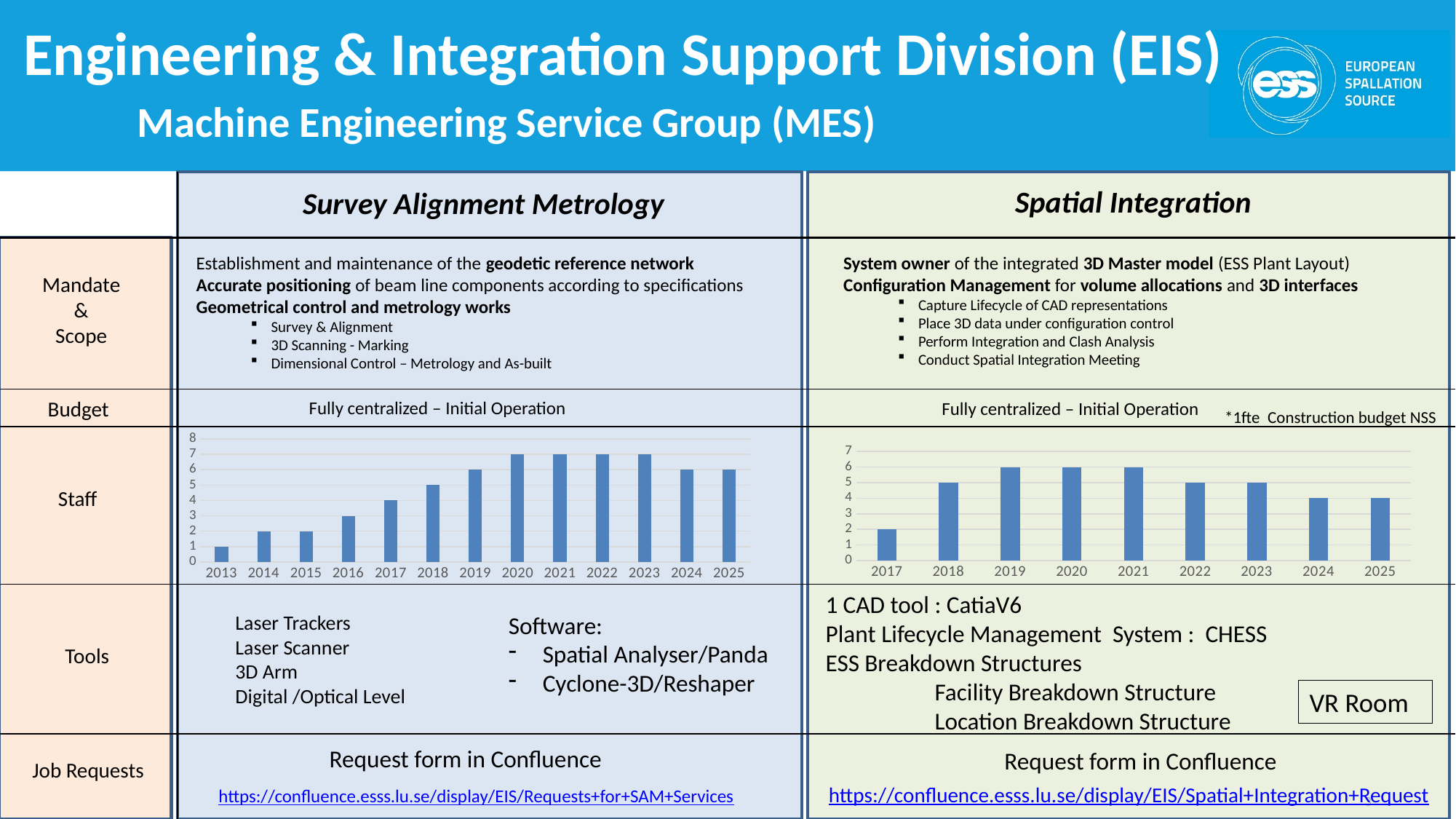
In the Spatial Integration staff chart, which is larger, the value for 2018 or the value for 2024? 2018 In the Survey Alignment Metrology staff chart, is the value for 2017 greater or less than 5? less In the Spatial Integration staff chart, how many years are shown on the x axis? 9 In the Spatial Integration staff chart, what is the value for 2017? 2 In the Survey Alignment Metrology staff chart, what is the value for 2020? 7 In the Survey Alignment Metrology staff chart, what is the value for 2013? 1 In the Survey Alignment Metrology staff chart, what is the difference between the values for 2018 and 2013? 4 In the Survey Alignment Metrology staff chart, how many years are shown on the x axis? 13 What kind of chart is the Spatial Integration staff chart? bar chart In the Spatial Integration staff chart, which year has the lowest value? 2017 In the Spatial Integration staff chart, what is the value for 2025? 4 In the Survey Alignment Metrology staff chart, which year has the lowest value? 2013